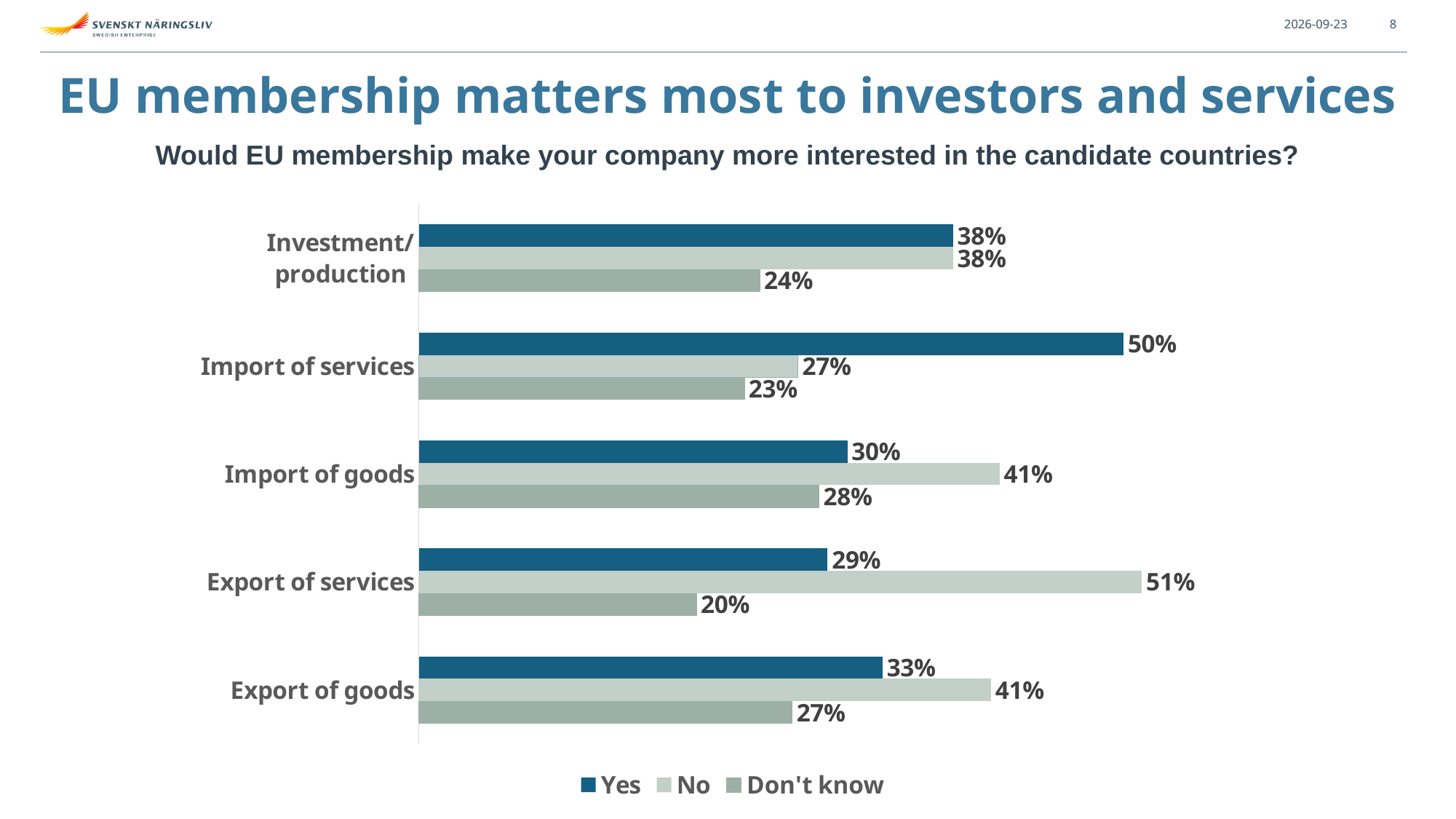
What percentage answered Yes for Import of services? 50% What percentage answered No for Export of services? 51% How many categories are shown on the chart? 5 What is the difference between the No and Yes shares for Export of services? 22% How many series does the legend list? 3 Which is larger for Import of goods, the Yes share or the No share? No What percentage answered Don't know for Investment/production? 24% What is the total of Yes, No and Don't know for Export of goods? 101% Which category has the highest Yes share? Import of services What question is the chart based on, as shown in the subtitle? Would EU membership make your company more interested in the candidate countries? Which category has the lowest Don't know share? Export of services What kind of chart is shown on the slide? Bar chart